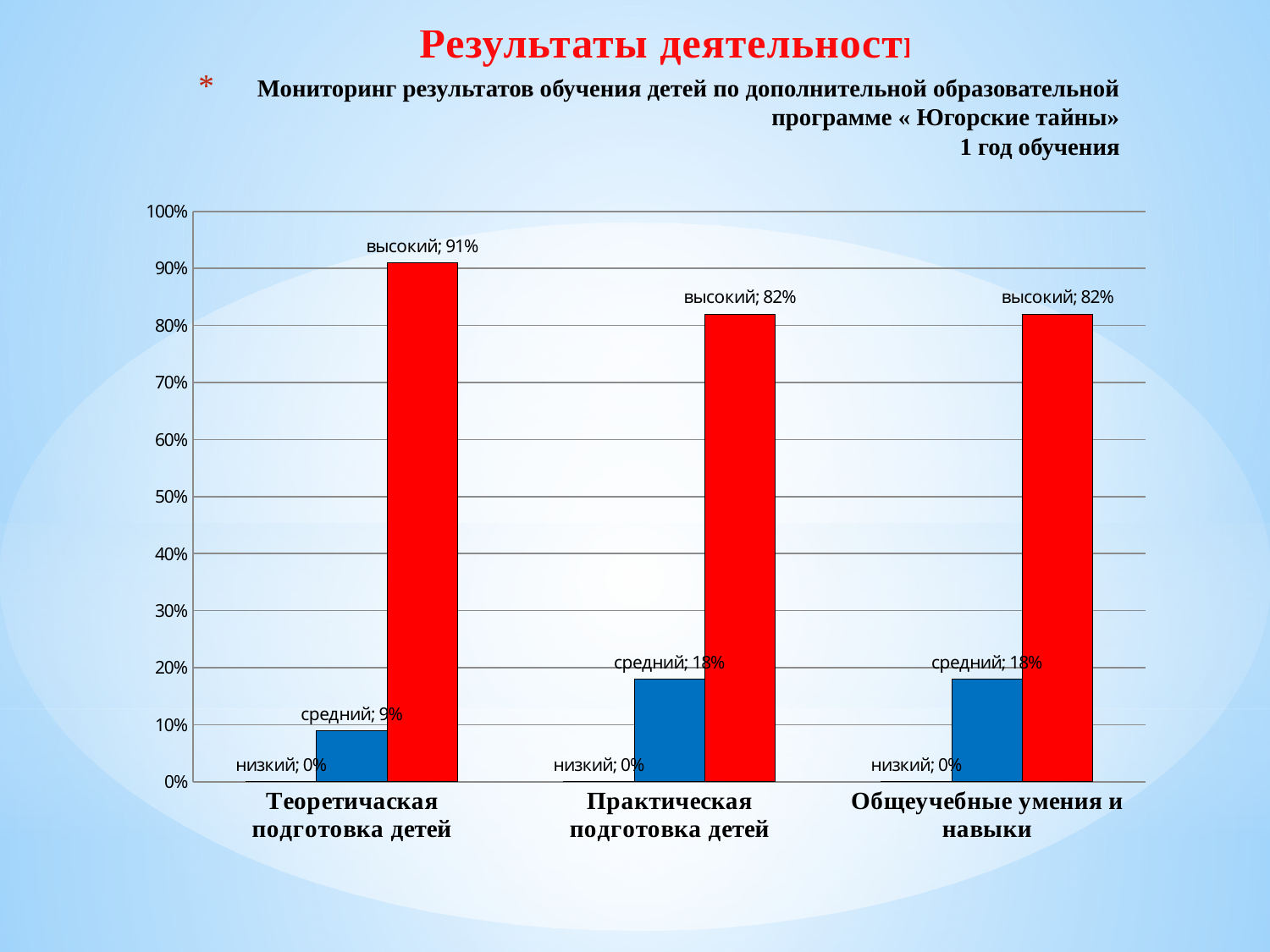
In which category is the "высокий" value the highest? Теоретическая подготовка детей Which is larger: the "средний" value for "Теоретическая подготовка детей" or for "Общеучебные умения и навыки"? Общеучебные умения и навыки What is the difference between the "высокий" values for "Теоретическая подготовка детей" and "Практическая подготовка детей"? 9% What is the value for "средний" in the "Практическая подготовка детей" category? 18% In which category is the "средний" value the lowest? Теоретическая подготовка детей What kind of chart is shown on the slide? Bar chart How many series (levels) are plotted for each category? 3 How many categories are shown on the x axis? 3 What is the value for "высокий" in the "Теоретическая подготовка детей" category? 91% What is the value for "низкий" in the "Общеучебные умения и навыки" category? 0% What is the value for "средний" in the "Теоретическая подготовка детей" category? 9% What colour are the bars for the "высокий" level? Red